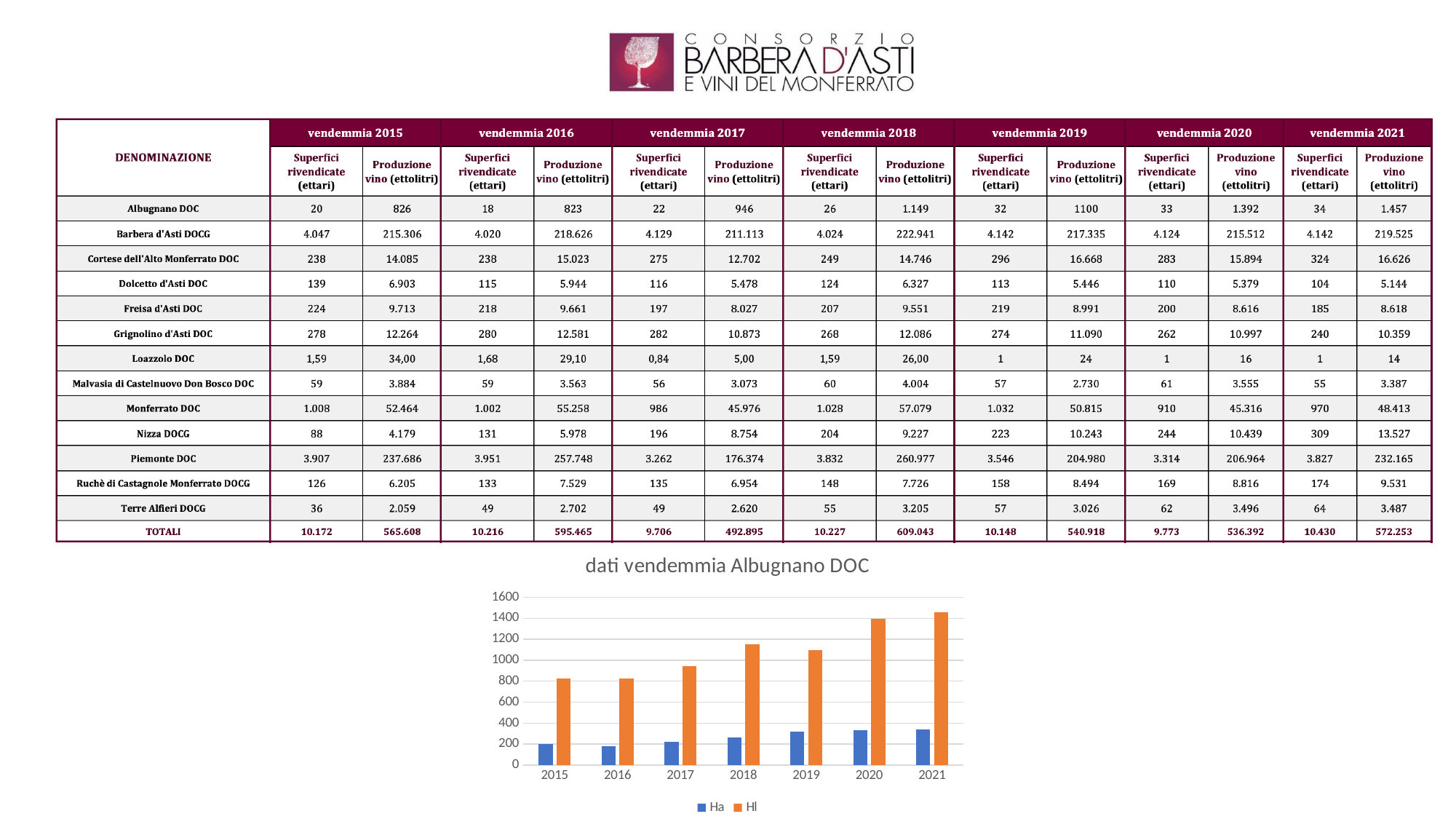
In the chart, do the Hl values generally rise or fall from 2015 to 2021? rise How many years are shown on the x axis of the chart? 7 In the chart, which is larger: the Hl value for 2018 or the Hl value for 2019? 2018 What kind of chart is shown below the table on the slide? bar chart In the chart, is the Hl value for 2021 greater or less than 1200? greater What are the two series named in the chart legend? Ha and Hl In the chart, is the Hl value for 2015 greater or less than 1000? less In the chart, is the Ha value for 2015 greater or less than 400? less In the chart, which year has the highest Hl bar? 2021 What is the title of the chart on the slide? dati vendemmia Albugnano DOC How many series does the legend of the chart list? 2